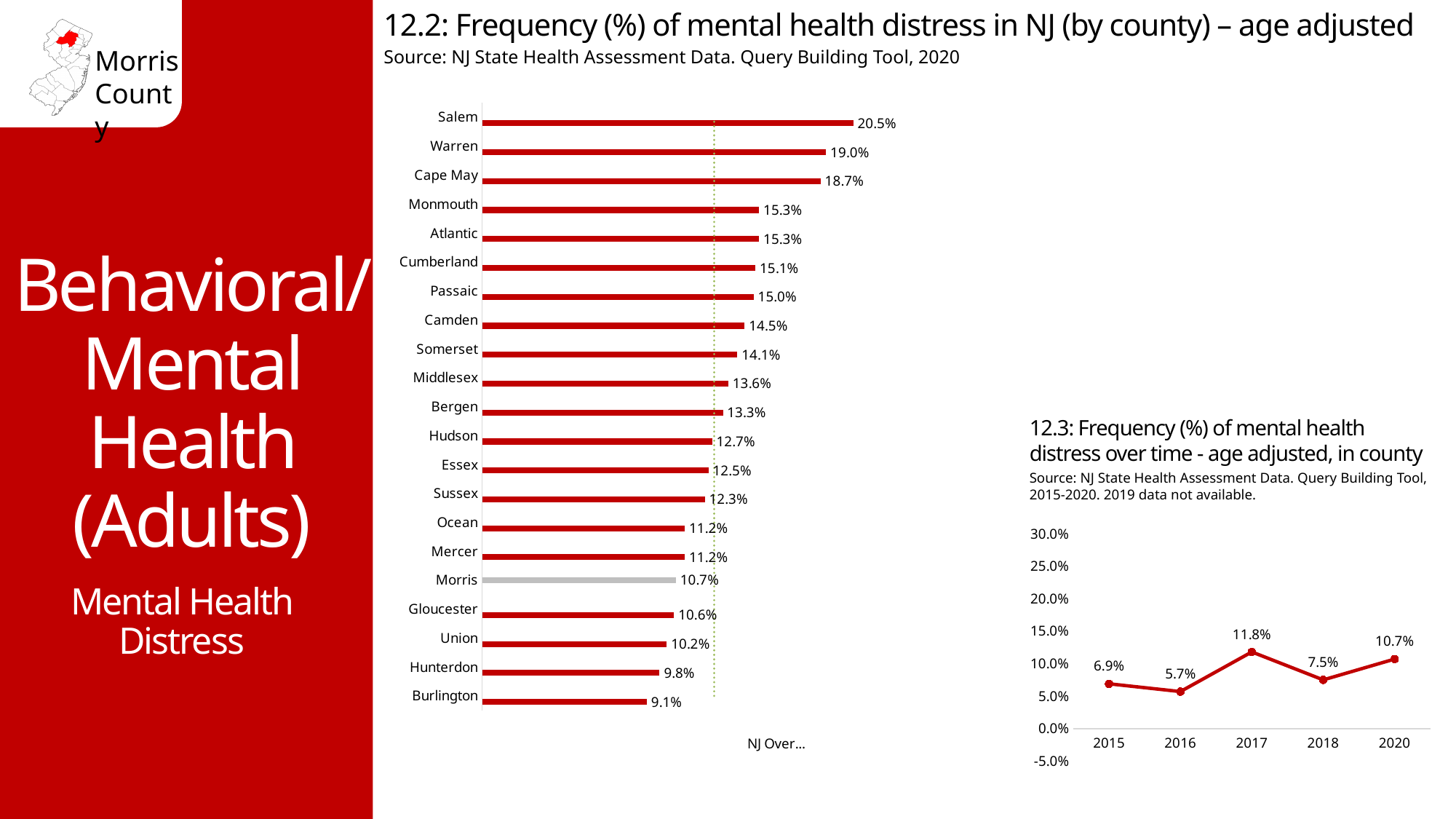
What kind of chart is chart 12.3 (Frequency of mental health distress over time in county)? Line chart In chart 12.2 (Frequency of mental health distress in NJ by county), what is the value for Morris? 10.7% In chart 12.3 (Frequency of mental health distress over time in county), which year has the lowest value? 2016 In chart 12.3 (Frequency of mental health distress over time in county), what is the value for 2017? 11.8% In chart 12.3 (Frequency of mental health distress over time in county), what is the difference between 2017 and 2018? 4.3% In chart 12.2 (Frequency of mental health distress in NJ by county), which is larger, Warren or Cape May? Warren In chart 12.2 (Frequency of mental health distress in NJ by county), how many counties are shown? 21 In chart 12.2 (Frequency of mental health distress in NJ by county), which county has the highest value? Salem In chart 12.2 (Frequency of mental health distress in NJ by county), what is the difference between Salem and Burlington? 11.4% In chart 12.2 (Frequency of mental health distress in NJ by county), what is the value for Hunterdon? 9.8% In chart 12.2 (Frequency of mental health distress in NJ by county), which county has the lowest value? Burlington What kind of chart is chart 12.2 (Frequency of mental health distress in NJ by county)? Bar chart